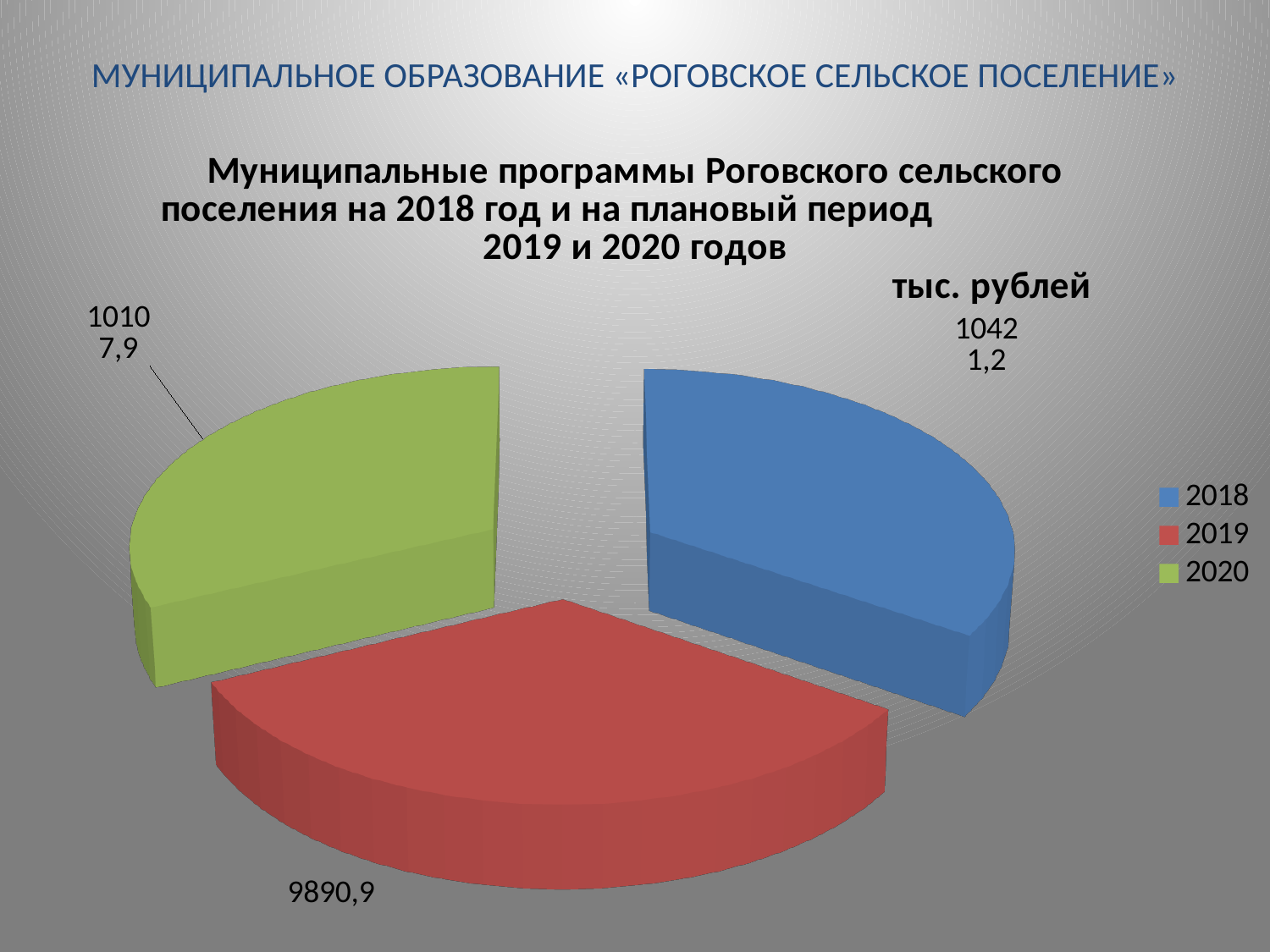
What is the value for 2018 in the pie chart? 10421,2 What is the difference between the values for 2020 and 2019? 217 What unit is stated for the values in the chart? тыс. рублей Which year has the highest value in the pie chart? 2018 What is the difference between the values for 2018 and 2019? 530,3 How many slices does the pie chart have? 3 How many entries does the legend list? 3 Which is larger, the value for 2018 or the value for 2020? 2018 What type of chart is shown on the slide? pie chart What is the value for 2019 in the pie chart? 9890,9 What is the value for 2020 in the pie chart? 10107,9 Which year has the lowest value in the pie chart? 2019